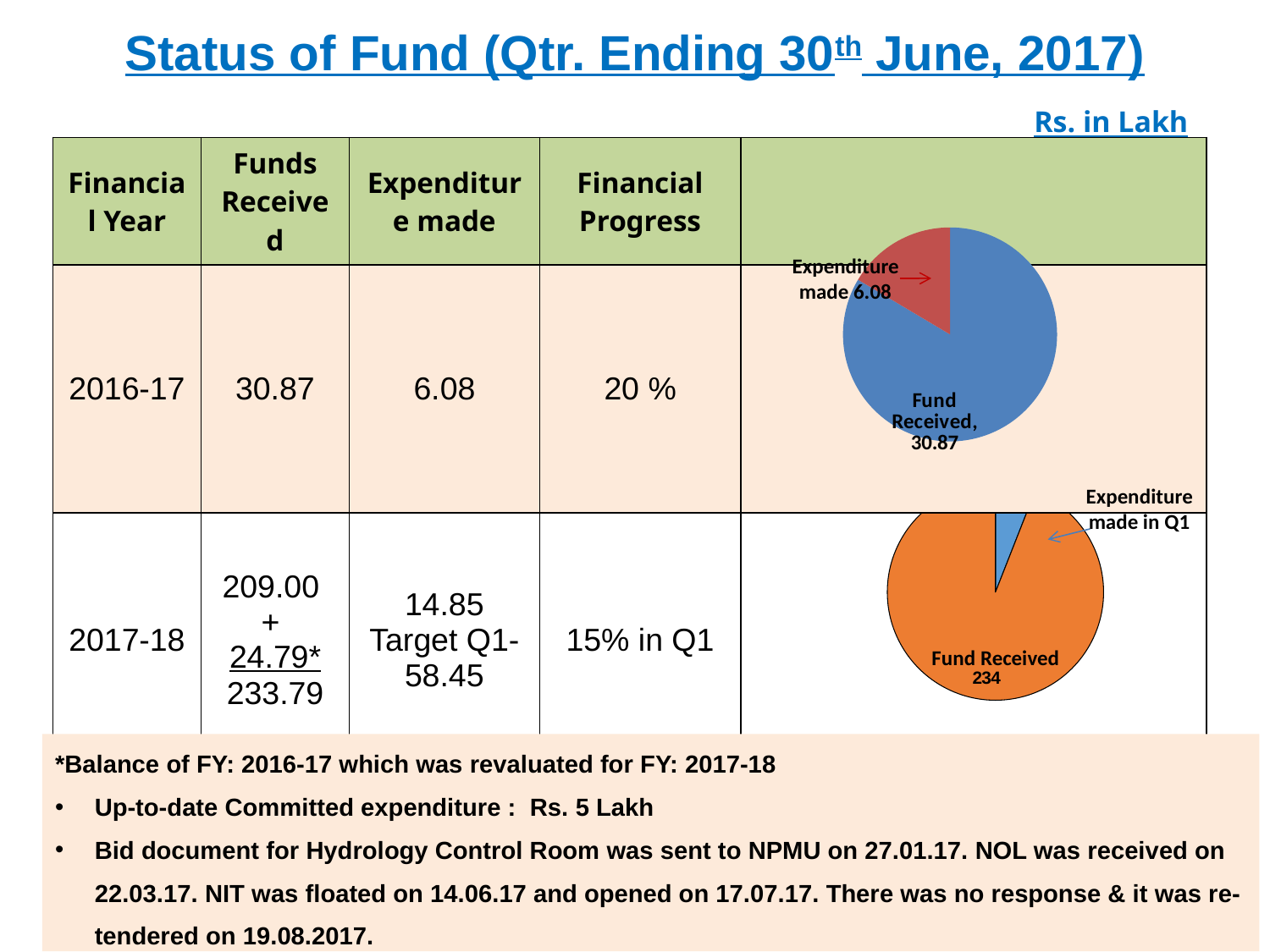
How many slices does the top pie chart (2016-17) have? 2 What kind of chart is shown for the 2017-18 row (bottom chart)? pie chart In the bottom pie chart (2017-18), which slice is larger, Fund Received or Expenditure made in Q1? Fund Received What kind of chart is shown for the 2016-17 row (top chart)? pie chart In the top pie chart (2016-17), what is the value for Fund Received? 30.87 In the top pie chart (2016-17), what is the value for Expenditure made? 6.08 In the bottom pie chart (2017-18), what colour is the Fund Received slice? orange In the bottom pie chart (2017-18), what is the value for Fund Received? 234 In the top pie chart (2016-17), which slice is larger, Fund Received or Expenditure made? Fund Received In the top pie chart (2016-17), what is the difference between Fund Received and Expenditure made? 24.79 In the top pie chart (2016-17), what colour is the Expenditure made slice? red How many slices does the bottom pie chart (2017-18) have? 2